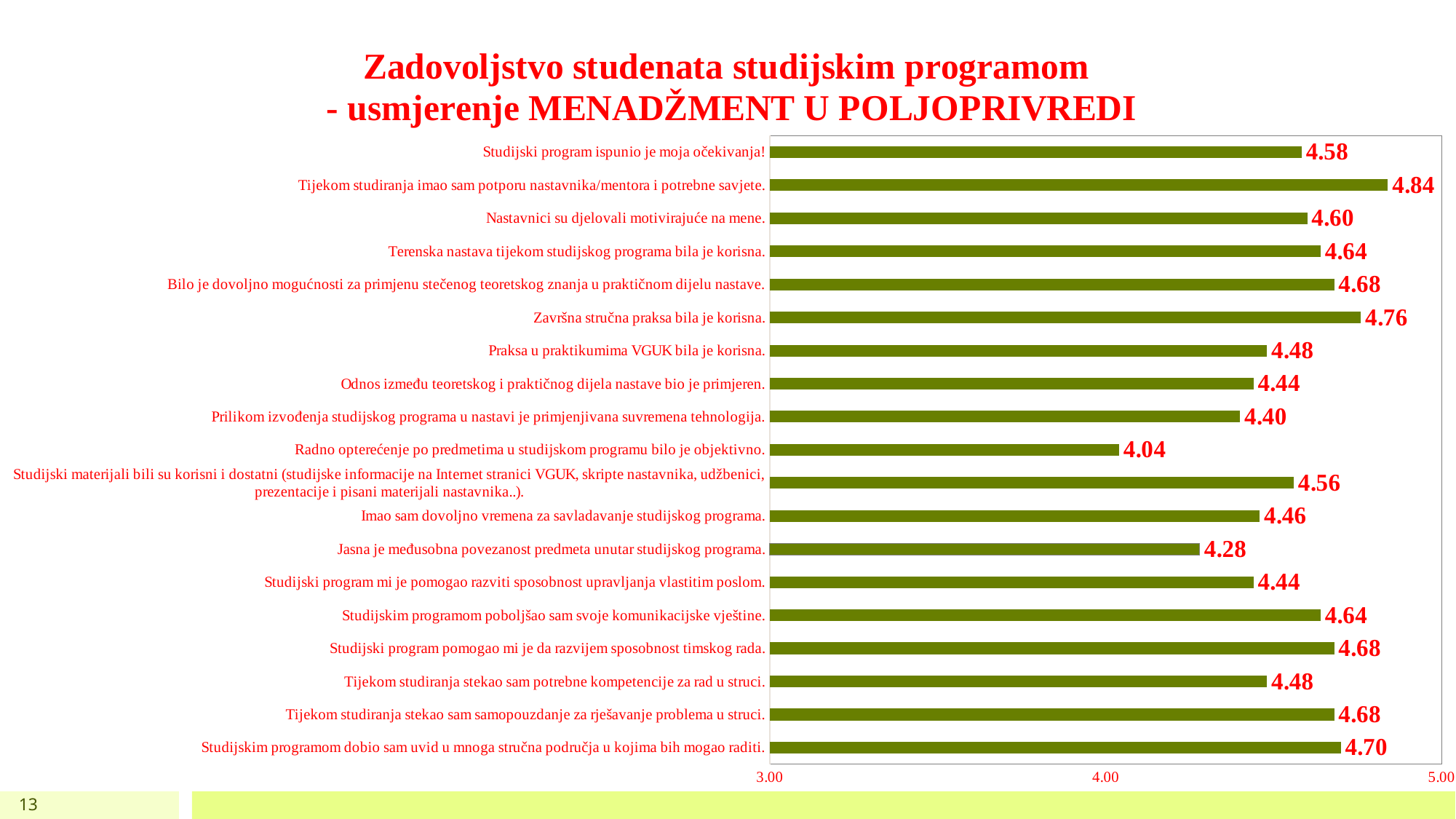
What kind of chart is shown on the slide? bar chart What is the value for "Radno opterećenje po predmetima u studijskom programu bilo je objektivno."? 4.04 What is the maximum value shown on the horizontal axis? 5.00 Which statement has the highest value? Tijekom studiranja imao sam potporu nastavnika/mentora i potrebne savjete. How many statements (bars) are shown in the chart? 19 What is the difference between the highest value (4.84) and the lowest value (4.04)? 0.80 Is the value for "Praksa u praktikumima VGUK bila je korisna." greater or less than 4.00? greater What is the value for "Završna stručna praksa bila je korisna."? 4.76 What is the difference between the values for "Nastavnici su djelovali motivirajuće na mene." and "Prilikom izvođenja studijskog programa u nastavi je primjenjivana suvremena tehnologija."? 0.20 What is the value for "Studijski program ispunio je moja očekivanja!"? 4.58 Which is larger: the value for "Jasna je međusobna povezanost predmeta unutar studijskog programa." or the value for "Imao sam dovoljno vremena za savladavanje studijskog programa."? Imao sam dovoljno vremena za savladavanje studijskog programa. Which statement has the lowest value? Radno opterećenje po predmetima u studijskom programu bilo je objektivno.